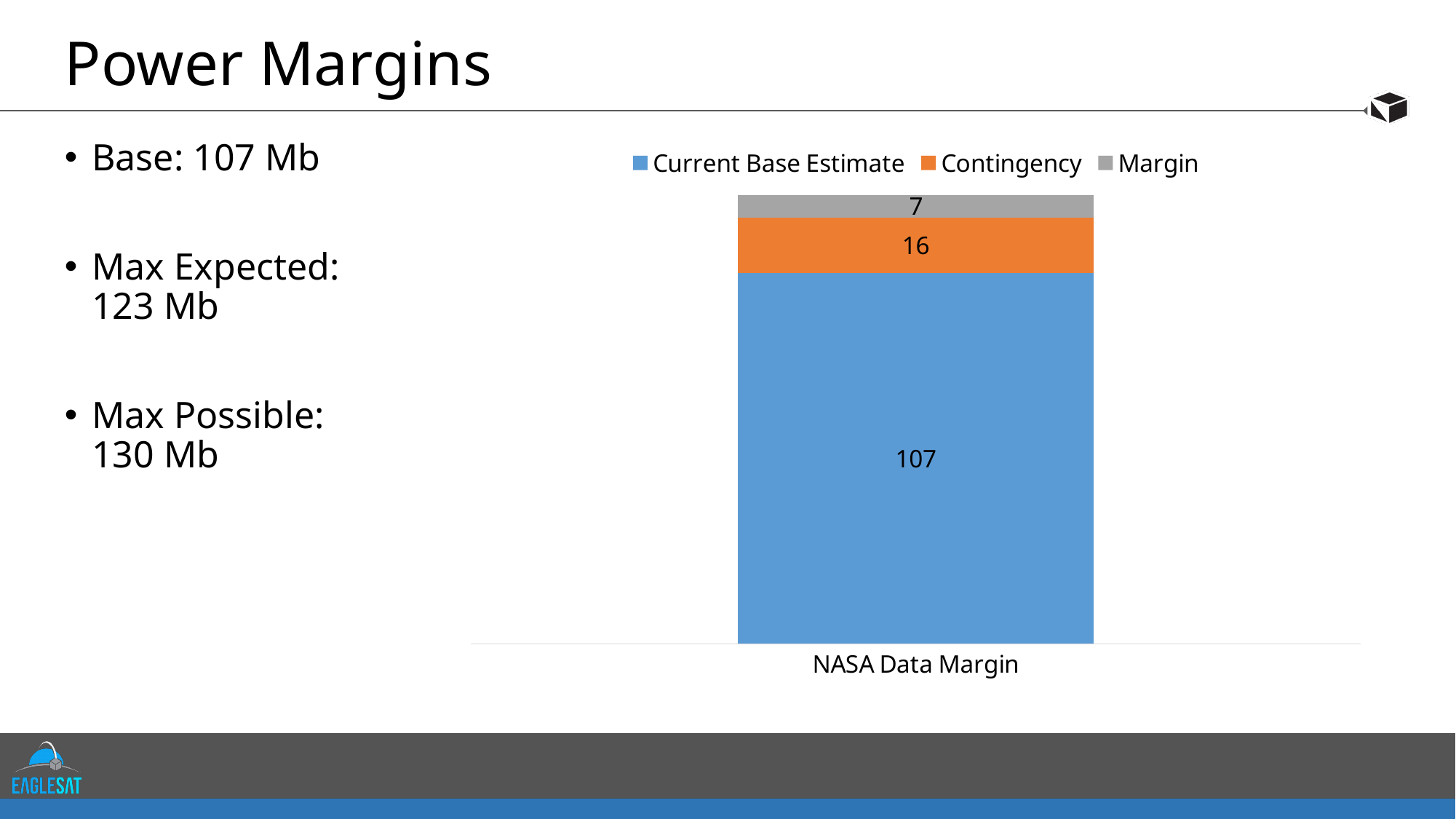
Which series has the largest value in the NASA Data Margin bar? Current Base Estimate What is the difference between the Contingency and Margin values? 9 What kind of chart is shown on the slide? Stacked bar chart What is the difference between the Current Base Estimate and Contingency values? 91 How many series does the legend list? 3 What is the value of the Contingency segment in the NASA Data Margin bar? 16 What is the value of the Margin segment in the NASA Data Margin bar? 7 Which is larger, the Contingency value or the Margin value? Contingency What is the total of the stacked NASA Data Margin bar? 130 What is the value of the Current Base Estimate segment in the NASA Data Margin bar? 107 Which series has the smallest value in the NASA Data Margin bar? Margin How many categories are shown on the x axis? 1